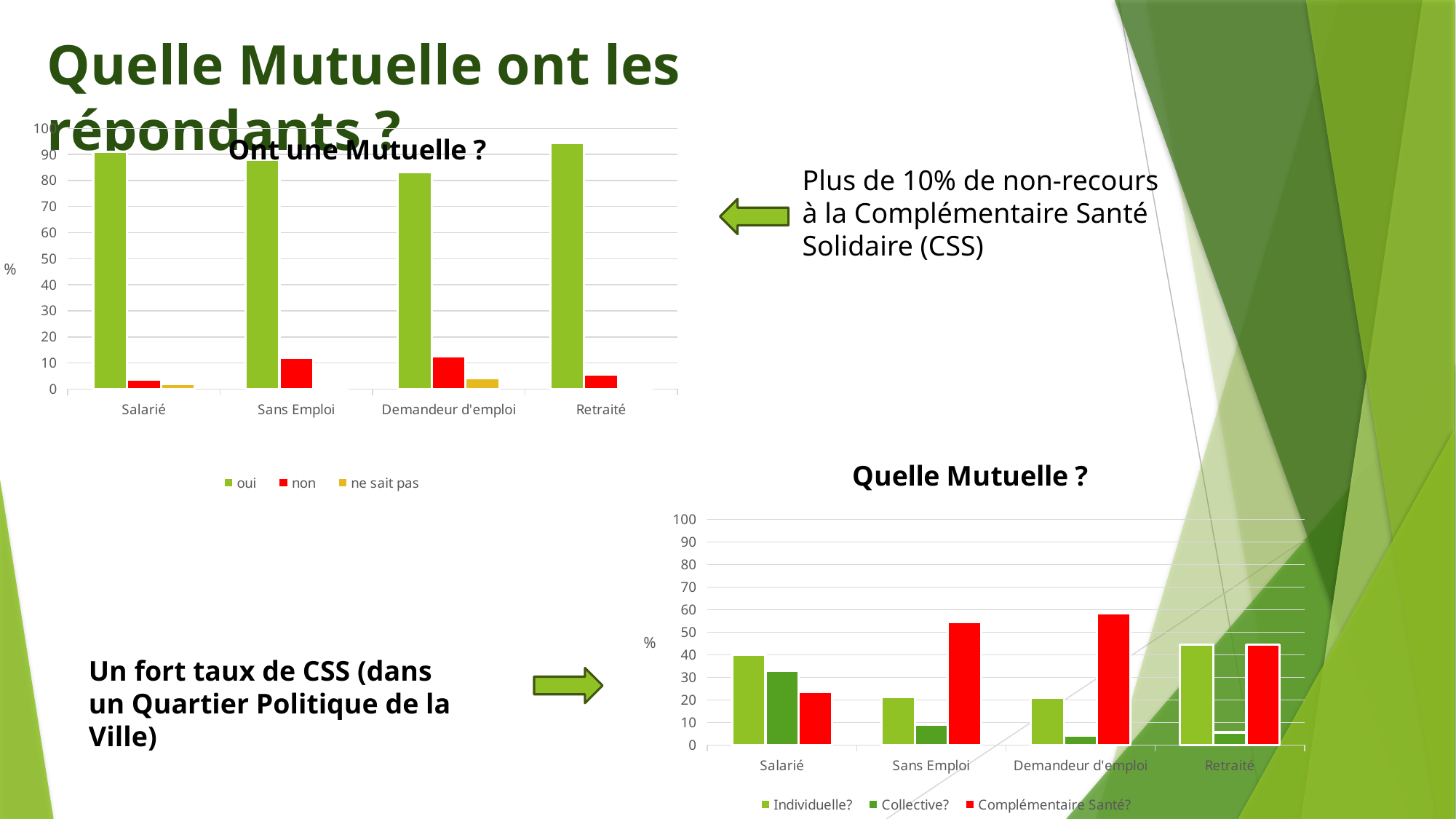
How many series does the legend of the 'Ont une Mutuelle ?' chart list? 3 In the 'Ont une Mutuelle ?' chart, which is larger: the 'non' value for Demandeur d'emploi or the 'non' value for Salarié? Demandeur d'emploi How many series does the legend of the 'Quelle Mutuelle ?' chart list? 3 How many categories are shown on the x axis of the 'Ont une Mutuelle ?' chart? 4 In the 'Ont une Mutuelle ?' chart, is the 'oui' value for Salarié greater or less than 80? greater What are the legend entries of the 'Quelle Mutuelle ?' chart? Individuelle?, Collective?, Complémentaire Santé? In the 'Quelle Mutuelle ?' chart, is the 'Complémentaire Santé?' value for Sans Emploi greater or less than 50? greater What kind of chart is the 'Ont une Mutuelle ?' chart? bar chart In the 'Quelle Mutuelle ?' chart, which is larger for Salarié: 'Individuelle?' or 'Collective?'? Individuelle? In the 'Ont une Mutuelle ?' chart, is the 'non' value for Sans Emploi greater or less than 20? less In the 'Quelle Mutuelle ?' chart, which category has the highest 'Complémentaire Santé?' value? Demandeur d'emploi In the 'Ont une Mutuelle ?' chart, which category has the lowest 'oui' value? Demandeur d'emploi